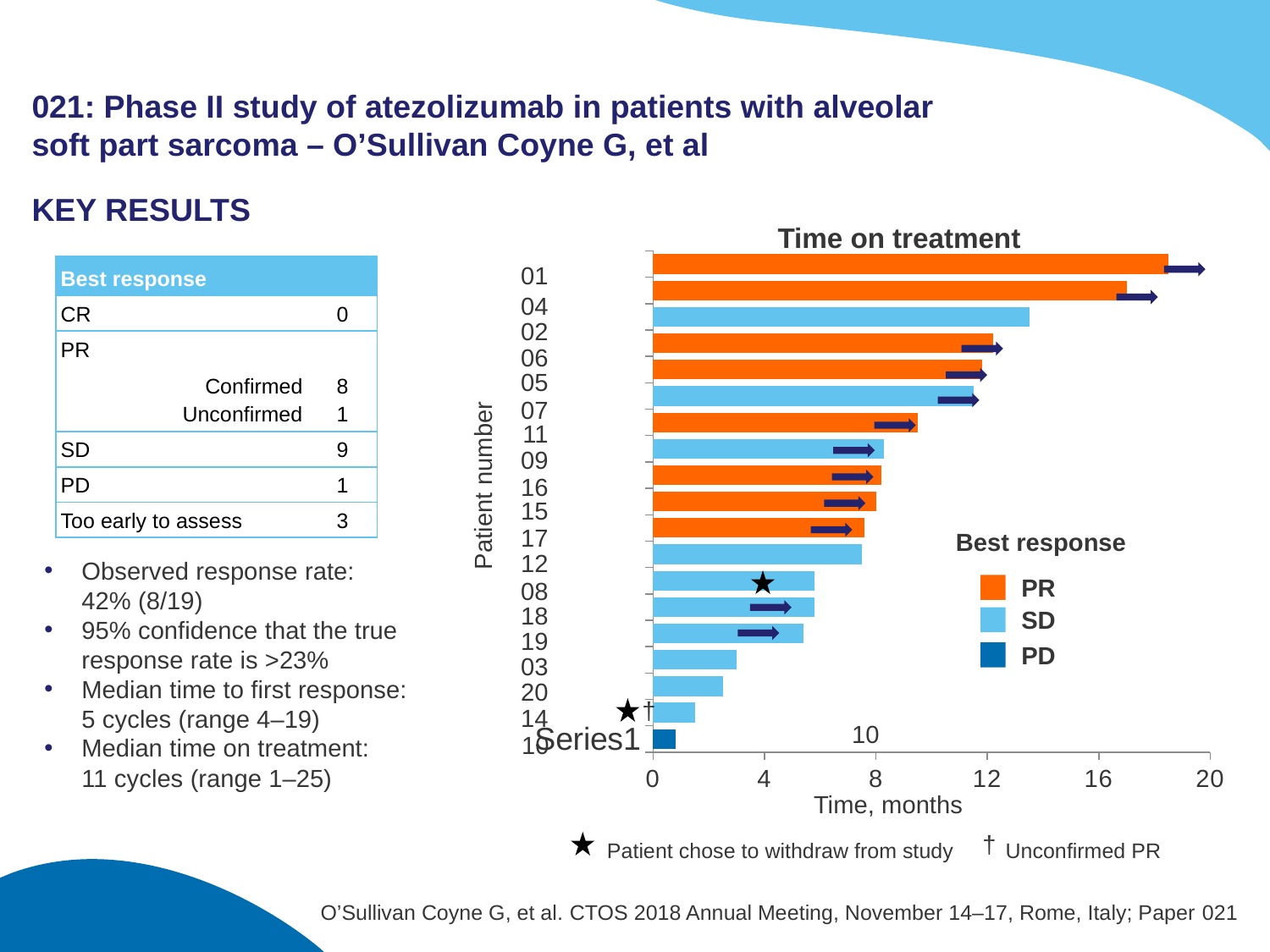
In the 'Time on treatment' chart, is the time on treatment for patient 01 greater or less than 16 months? greater In the 'Time on treatment' chart, which patient has a longer time on treatment, patient 01 or patient 10? 01 In the 'Time on treatment' chart, which patient has the longest time on treatment? 01 What is the title of the chart on the slide? Time on treatment In the 'Time on treatment' chart, is the time on treatment for patient 10 greater or less than 4 months? less In the 'Time on treatment' chart, which patient has the shortest time on treatment? 10 In the 'Time on treatment' chart, which best response category is shown by the dark blue bar? PD What is the x-axis label of the 'Time on treatment' chart? Time, months In the 'Time on treatment' chart, is the time on treatment for patient 04 greater or less than 12 months? greater In the 'Time on treatment' chart, do the bars get longer or shorter going from the top of the chart to the bottom? shorter What kind of chart is the 'Time on treatment' chart? Bar chart How many entries does the 'Best response' legend of the 'Time on treatment' chart list? 3